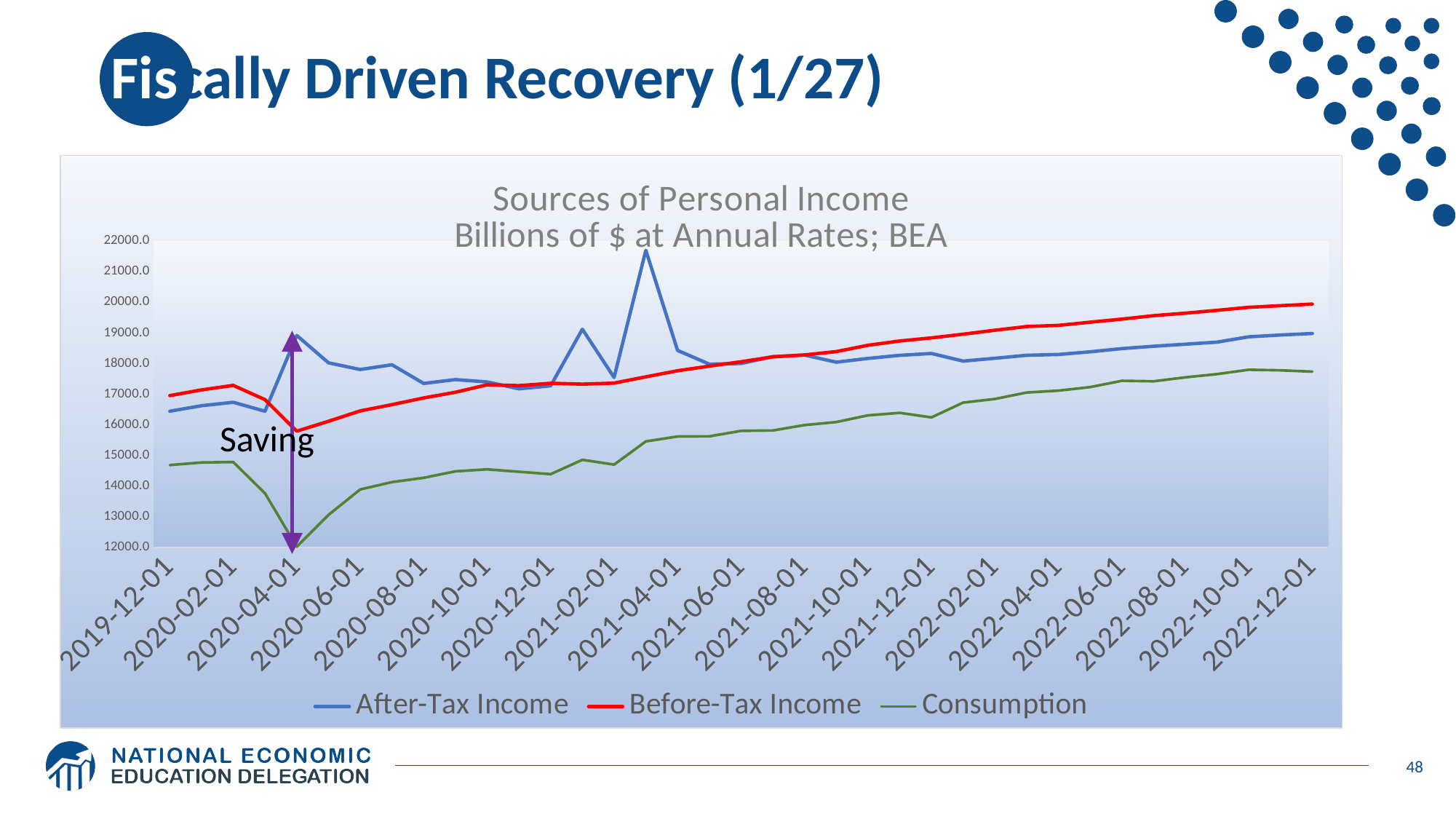
How many series does the chart's legend list? 3 Does Consumption rise or fall between 2021-06-01 and 2022-12-01? Rise Is the value of After-Tax Income at 2019-12-01 greater or less than 17000.0? less How many date labels are shown on the x axis? 19 At which labelled date is Consumption at its lowest? 2020-04-01 What kind of chart is shown on the slide? Line chart At 2020-04-01, which is larger: After-Tax Income or Before-Tax Income? After-Tax Income Which colour is used for the Consumption line? Green Is the value of Before-Tax Income at 2022-12-01 greater or less than 19000.0? greater What is the title of the chart? Sources of Personal Income Billions of $ at Annual Rates; BEA Is the value of Consumption at 2020-04-01 greater or less than 13000.0? less